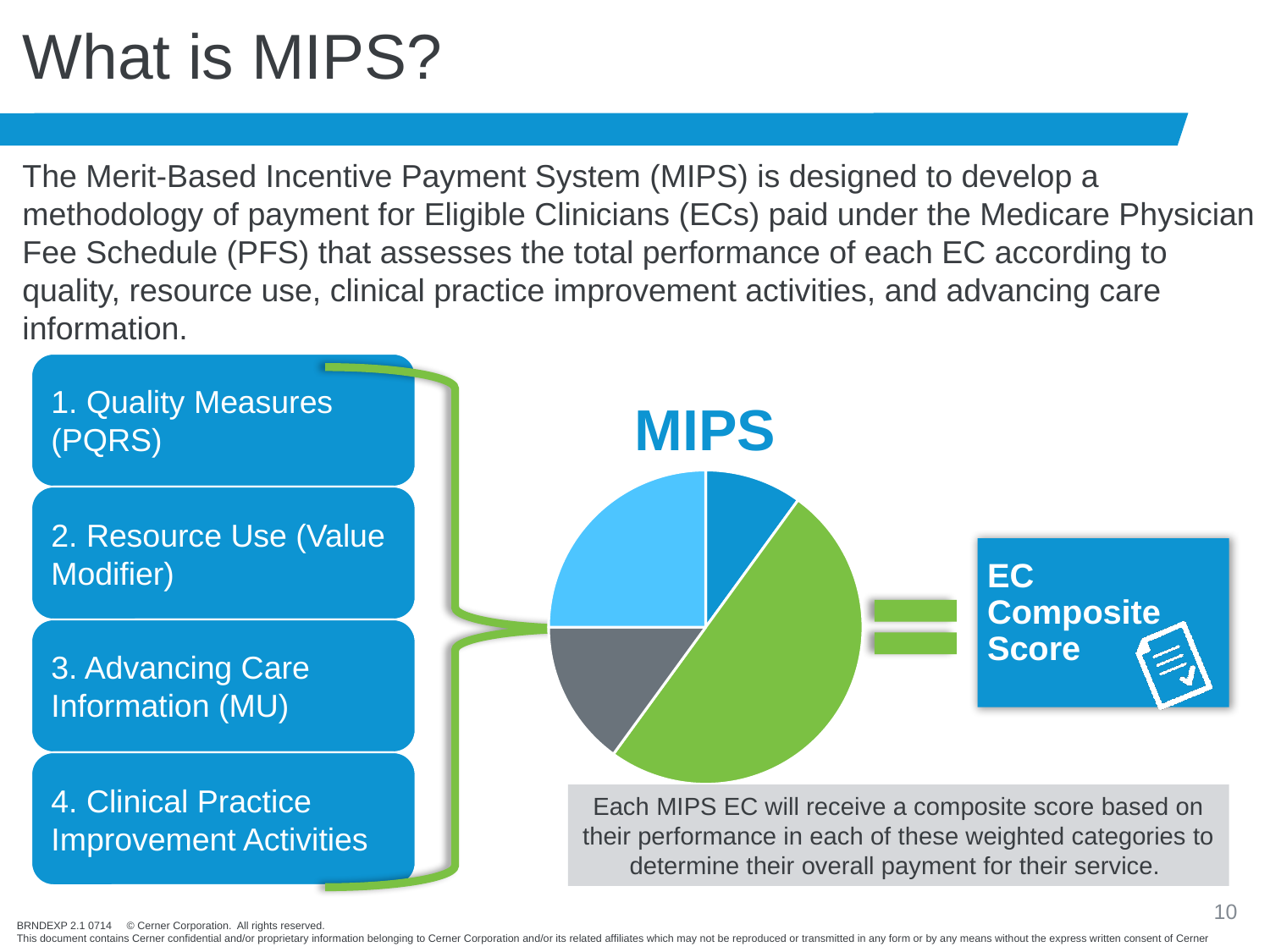
In the MIPS pie chart, is the grey slice or the dark blue slice larger? grey Does the MIPS pie chart display a legend? No What kind of chart is shown on the slide under the heading MIPS? pie chart In the MIPS pie chart, is the light blue slice or the grey slice larger? light blue Which colour slice is the smallest in the MIPS pie chart? dark blue How many slices does the MIPS pie chart have? 4 Which colour slice is the largest in the MIPS pie chart? green What is the title shown above the pie chart? MIPS In the MIPS pie chart, is the green slice or the light blue slice larger? green